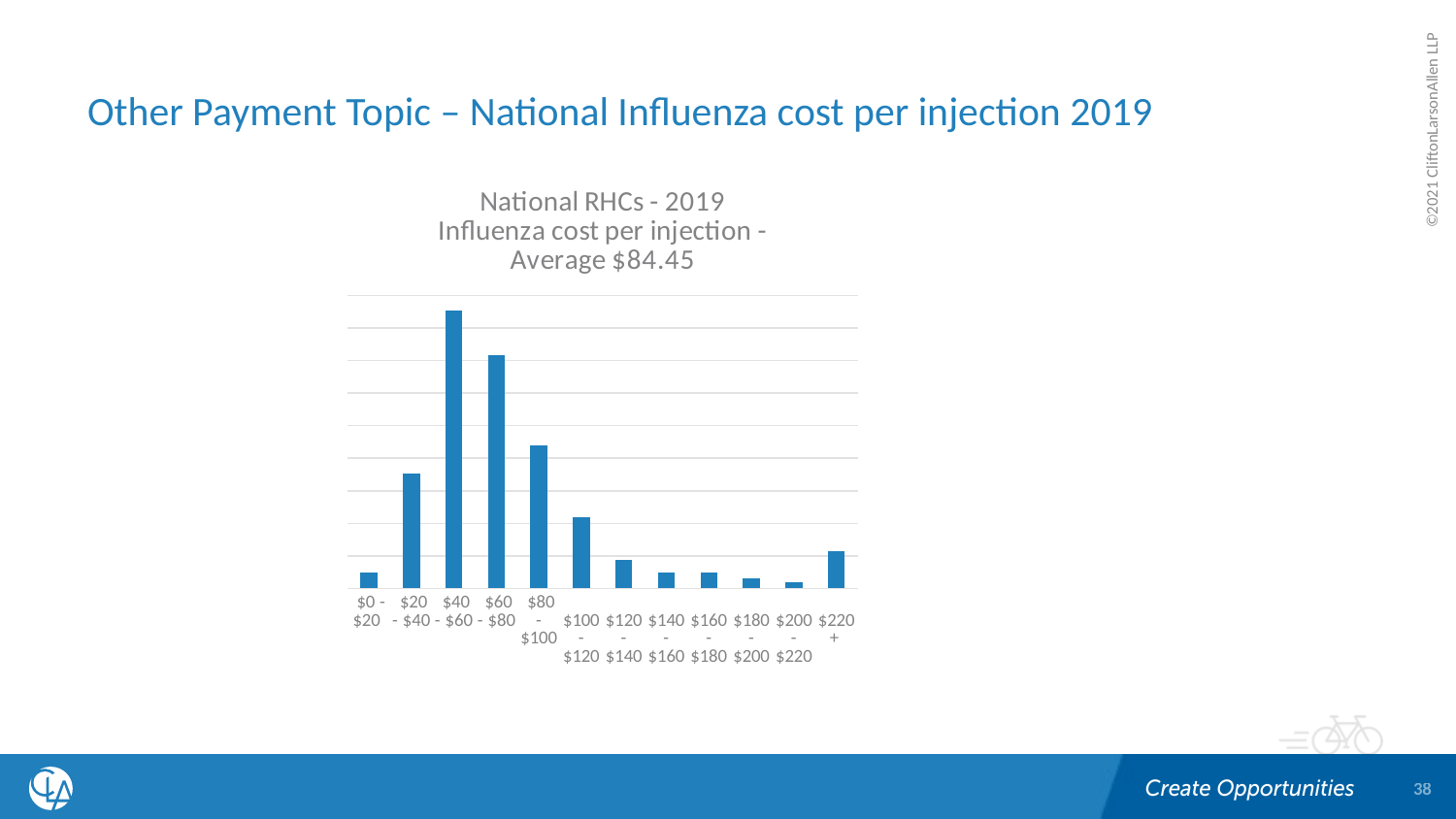
Which bar is taller: $40 - $60 or $60 - $80? $40 - $60 What kind of chart is shown on the slide? bar chart Do the bars rise or fall moving from the $0 - $20 range to the $40 - $60 range? rise Which cost range has the highest bar in the chart? $40 - $60 Do the bars rise or fall moving from the $40 - $60 range to the $200 - $220 range? fall Which bar is taller: $220+ or $200 - $220? $220+ How many cost ranges (categories) are shown on the x axis of the chart? 12 What average influenza cost per injection is stated in the chart title? $84.45 Which cost range has the lowest bar in the chart? $200 - $220 What is the title of the chart? National RHCs - 2019 Influenza cost per injection - Average $84.45 Which bar is taller: $100 - $120 or $120 - $140? $100 - $120